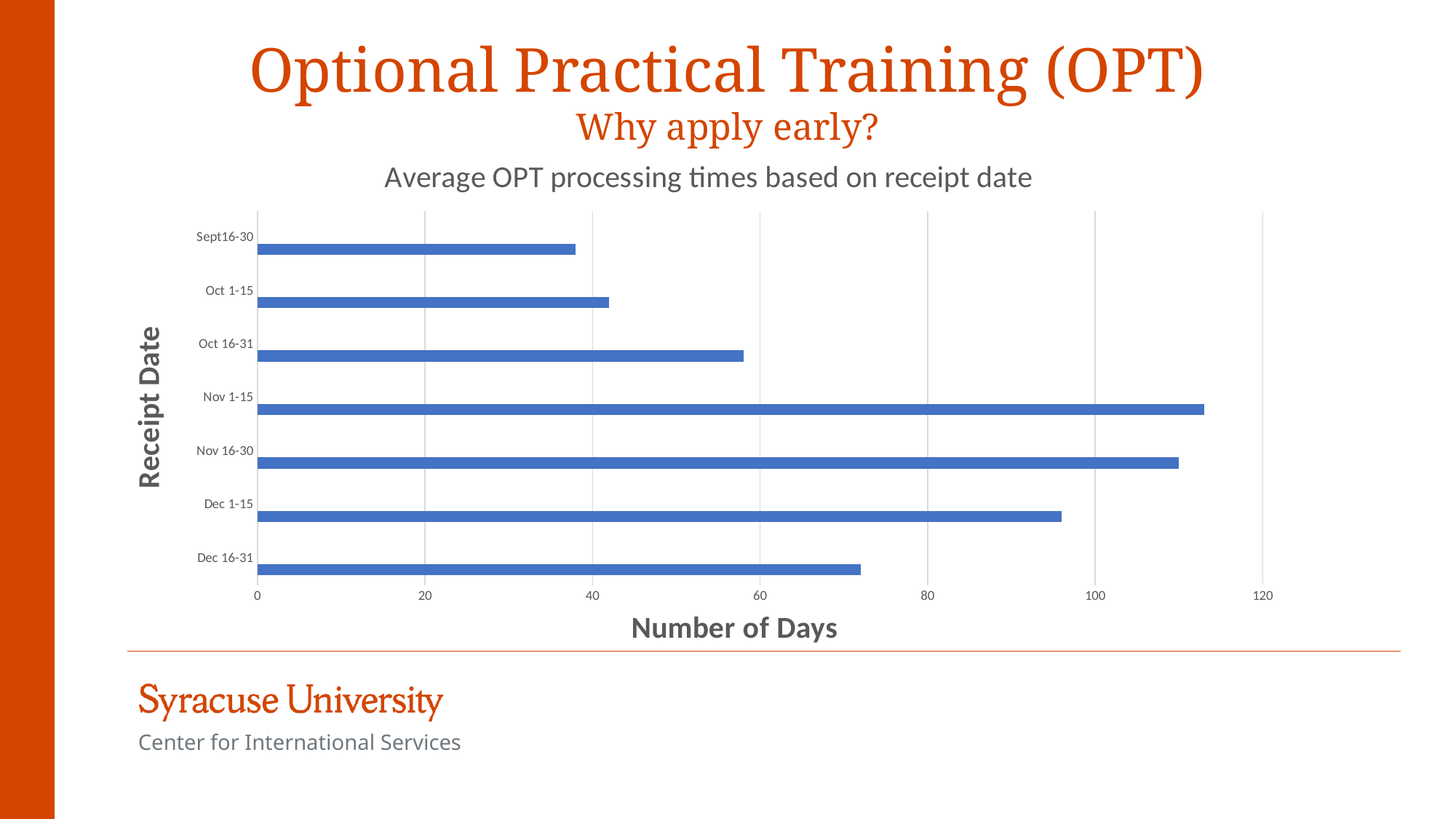
Is the value for Sept16-30 greater or less than 40? less Is the value for Dec 16-31 greater or less than 60? greater What is the title of the chart? Average OPT processing times based on receipt date Is the value for Oct 1-15 greater or less than 40? greater What kind of chart is shown on the slide? bar chart What is the label of the horizontal axis of the chart? Number of Days Which has a larger value, Oct 16-31 or Dec 16-31? Dec 16-31 How many receipt date categories are plotted in the chart? 7 Which receipt date has the lowest average OPT processing time? Sept16-30